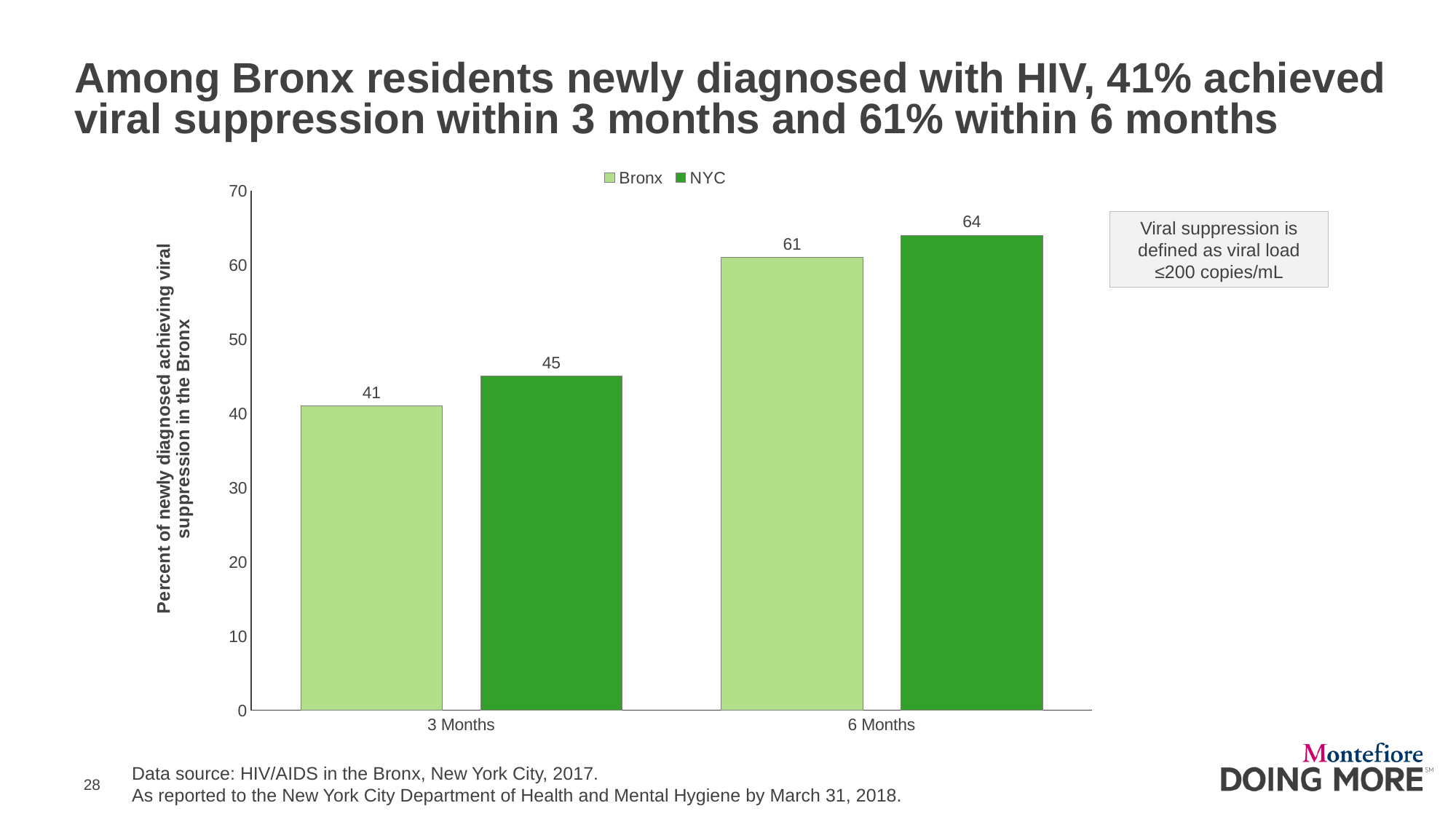
What kind of chart is shown on the slide? Bar chart How many series does the legend list? 2 Which bar has the highest value in the chart? NYC at 6 Months How many categories are shown on the x axis? 2 Which series has the higher value at 6 Months, Bronx or NYC? NYC What is the difference between the NYC and Bronx values at 3 Months? 4 What is the value for NYC at 6 Months? 64 What is the difference between the Bronx values at 6 Months and 3 Months? 20 Which bar has the lowest value in the chart? Bronx at 3 Months Do the Bronx values rise or fall from 3 Months to 6 Months? Rise What is the value for NYC at 3 Months? 45 What is the value for Bronx at 3 Months? 41